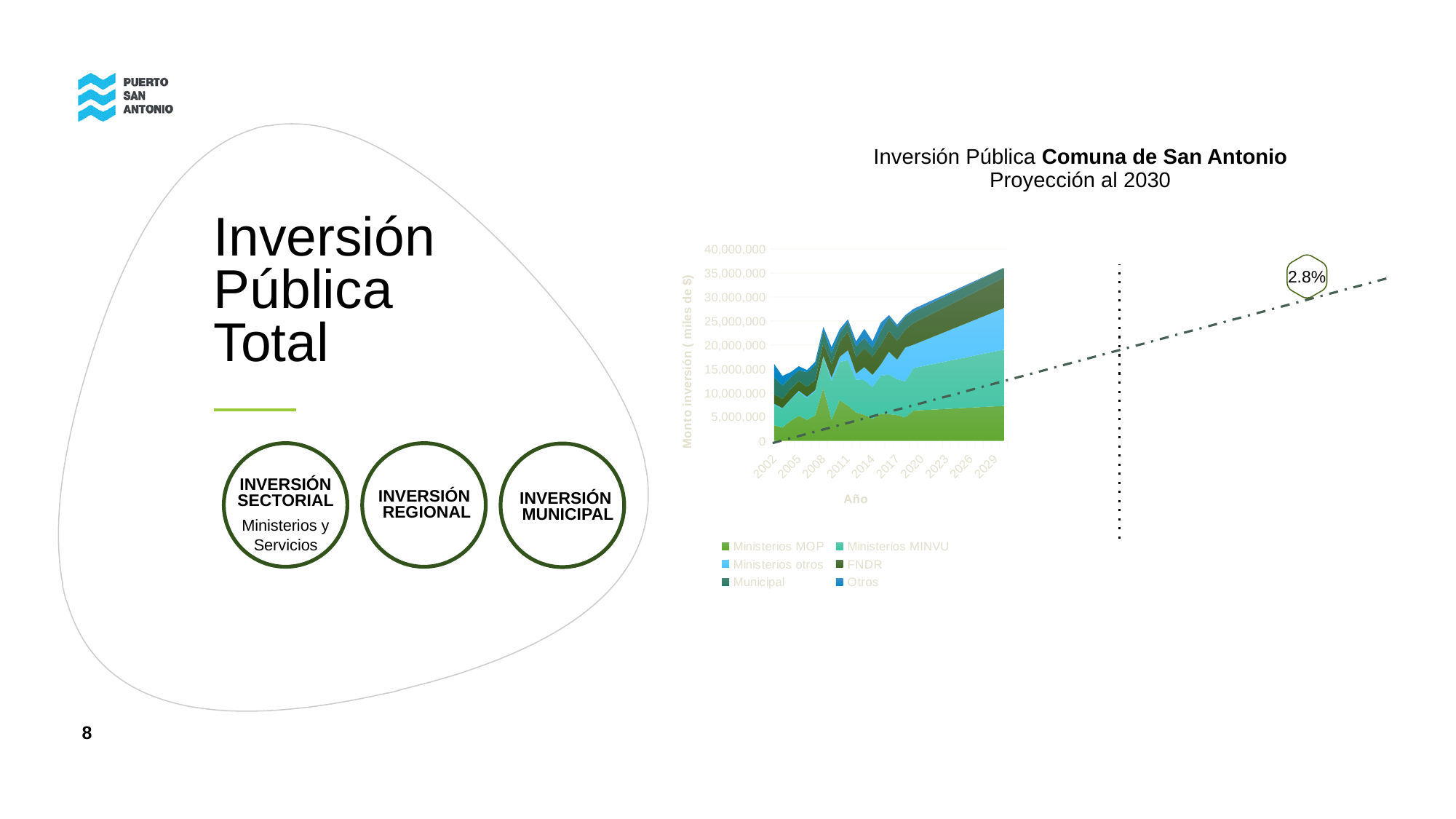
Which series is listed first in the chart legend? Ministerios MOP Is the total stacked value for 2029 greater or less than 30,000,000? greater What kind of chart is shown on the slide? Stacked area chart Is the Ministerios MOP value for 2029 greater or less than 10,000,000? less How many series does the chart legend list? 6 What is the highest value shown on the chart's vertical axis? 40,000,000 What is the title of the chart? Inversión Pública Comuna de San Antonio Proyección al 2030 Does the total public investment rise or fall from 2002 to 2029 in the chart? Rise Is the total stacked value for 2002 greater or less than 20,000,000? less How many year labels are shown on the chart's horizontal axis? 10